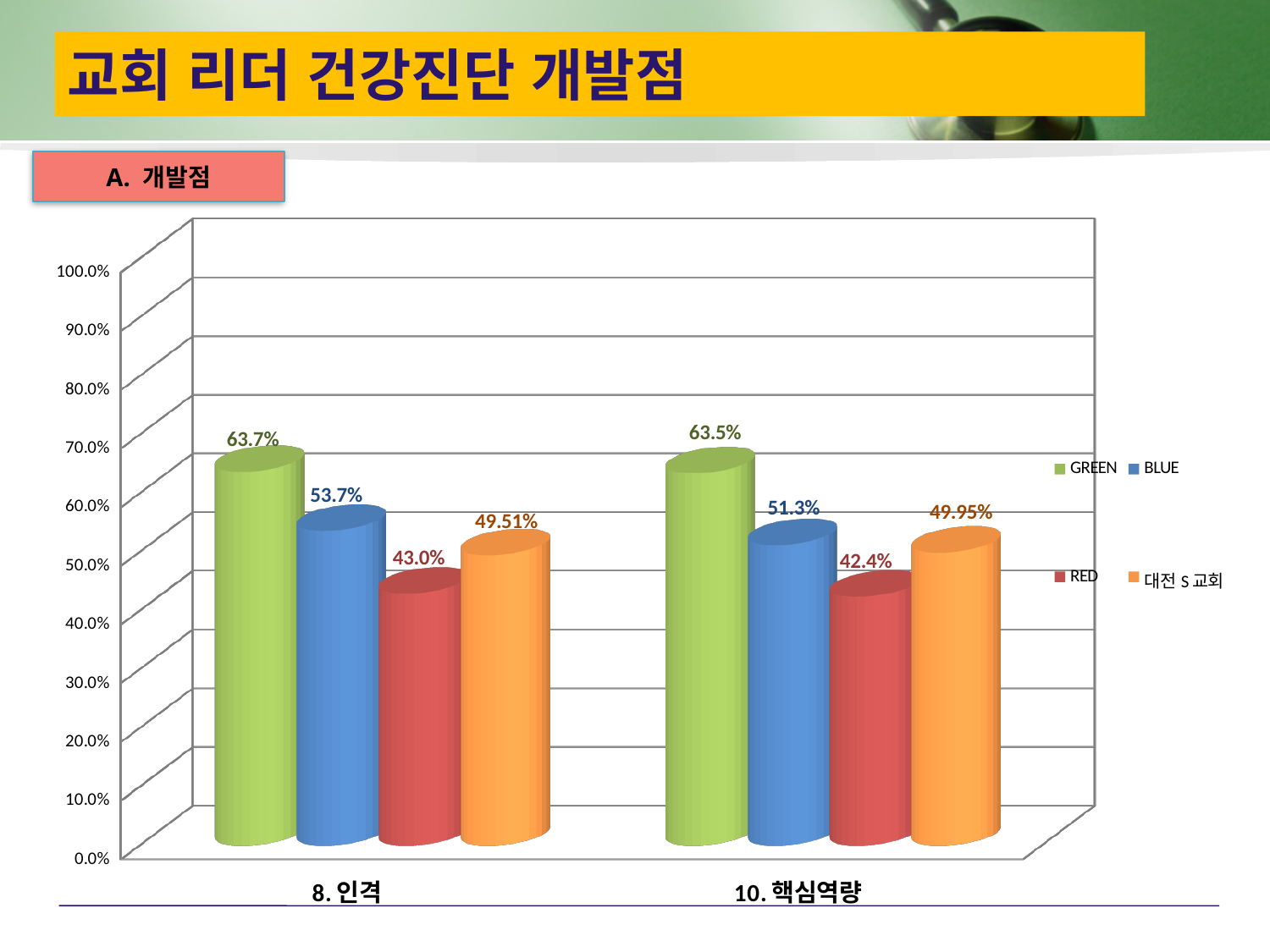
What kind of chart is shown on the slide? bar chart What is the value for BLUE in the 10. 핵심역량 category? 51.3% Which is larger: the BLUE value for 8. 인격 or the BLUE value for 10. 핵심역량? 8. 인격 How many series does the legend list? 4 What is the value for GREEN in the 8. 인격 category? 63.7% What is the value for RED in the 8. 인격 category? 43.0% How many categories are shown on the x axis? 2 Which series has the lowest value in the 8. 인격 category? RED What is the difference between the GREEN and BLUE values in the 8. 인격 category? 10.0% Is the RED value for 10. 핵심역량 greater or less than 50.0%? less Which series has the highest value in the 10. 핵심역량 category? GREEN What is the value for 대전 S 교회 in the 10. 핵심역량 category? 49.95%